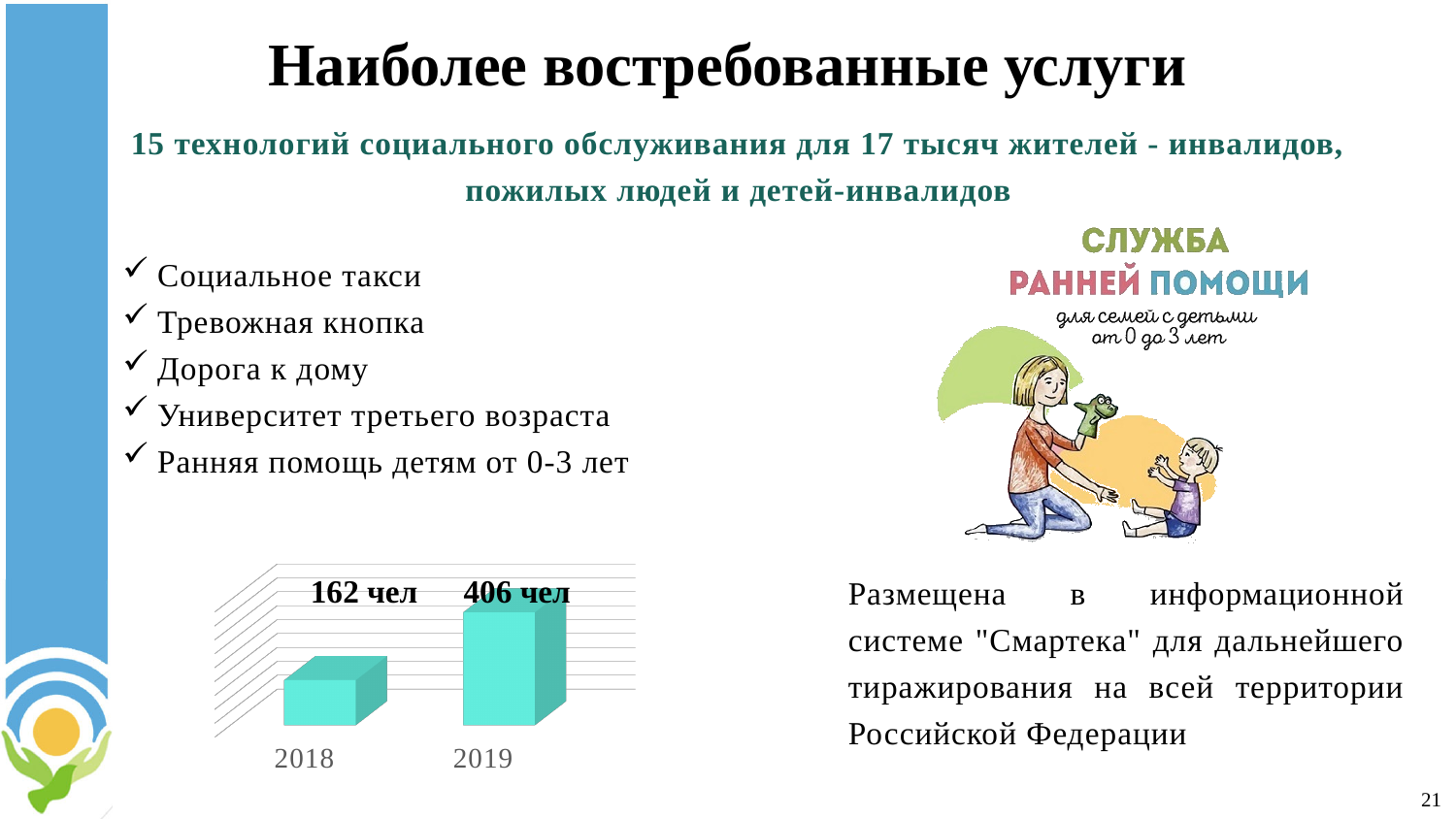
What is the difference between the 2019 and 2018 values in the bar chart? 244 чел How many categories (years) are shown in the bar chart? 2 Which is larger in the bar chart, the value for 2018 or the value for 2019? 2019 What is the value for 2019 in the bar chart? 406 чел Which year has the lowest value in the bar chart? 2018 What is the value for 2018 in the bar chart? 162 чел What colour are the bars in the chart? Turquoise Which year has the highest value in the bar chart? 2019 Do the values in the bar chart rise or fall from 2018 to 2019? Rise What kind of chart is shown on the slide? Bar chart What unit is shown on the data labels of the bar chart? чел